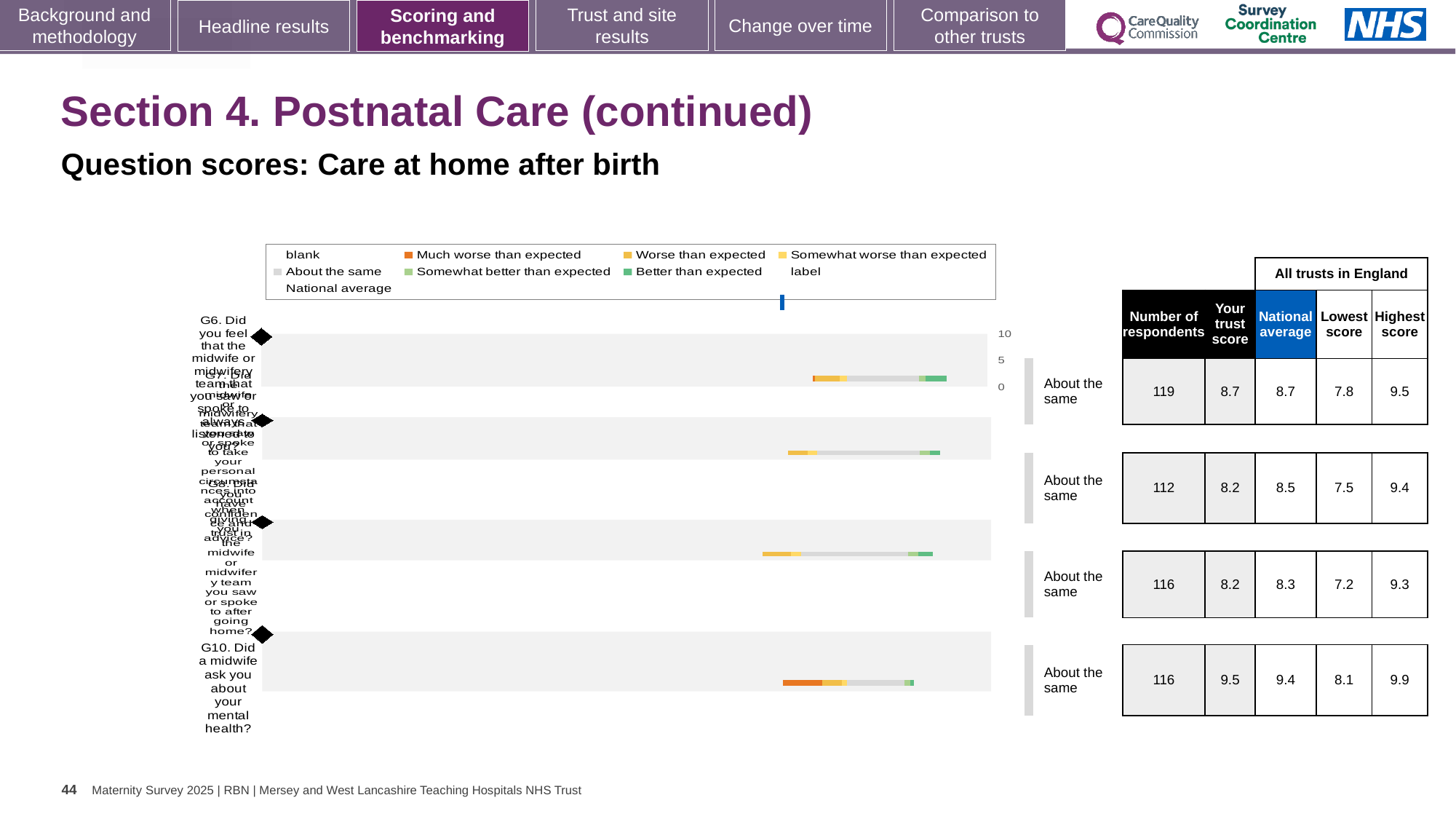
What is the difference between the highest score and the lowest score for G10 (Did a midwife ask you about your mental health?)? 1.8 Which has the larger 'Your trust score': G6 (midwife or midwifery team listened to you) or G10 (midwife asked about your mental health)? G10 What kind of chart is shown on the slide? bar chart What benchmark category is shown for every question in the chart? About the same How many questions (bars) are plotted in the chart? 4 What is the highest score across all trusts in England for G10 (Did a midwife ask you about your mental health?)? 9.9 What is the national average for G10 (Did a midwife ask you about your mental health?)? 9.4 What is the lowest 'Lowest score' value shown in the table? 7.2 What is the 'Your trust score' for G10 (Did a midwife ask you about your mental health?)? 9.5 Which question has the highest 'Your trust score'? G10. Did a midwife ask you about your mental health? What is the number of respondents for G6 (Did you feel that the midwife or midwifery team listened to you?)? 119 Which colour does the legend use for 'Much worse than expected'? orange